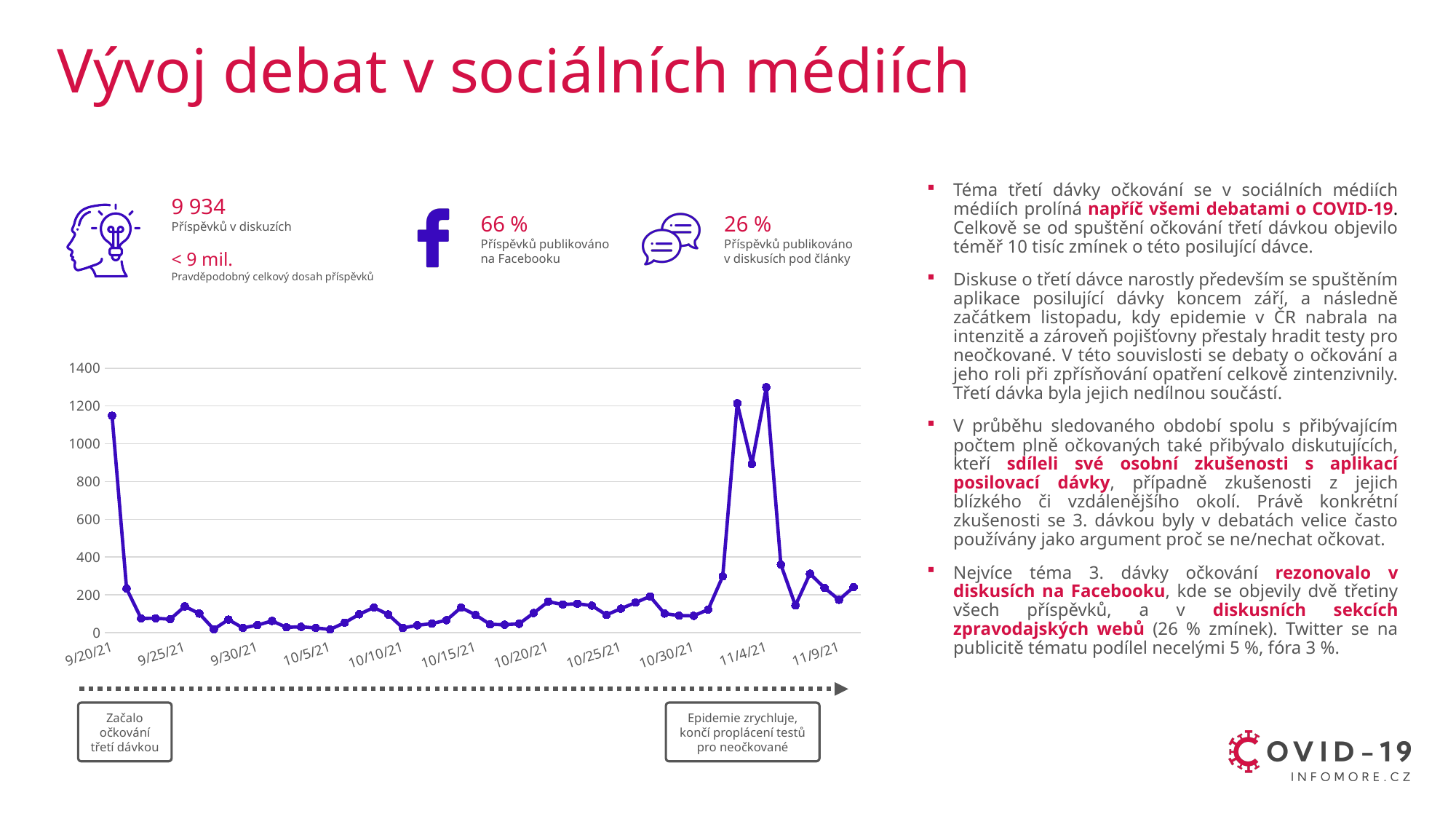
Is the value for 9/20/21 greater or less than 1000? greater Which is larger, the value for 9/20/21 or the value for 10/10/21? 9/20/21 What is the first date label on the x axis? 9/20/21 What is the highest value shown on the y axis? 1400 What kind of chart is shown on the slide? line chart Is the value for 10/5/21 greater or less than 200? less Is the highest point on the chart greater or less than 1200? greater How many date labels are shown on the x axis? 11 Do the values rise or fall between 9/20/21 and 9/25/21? fall